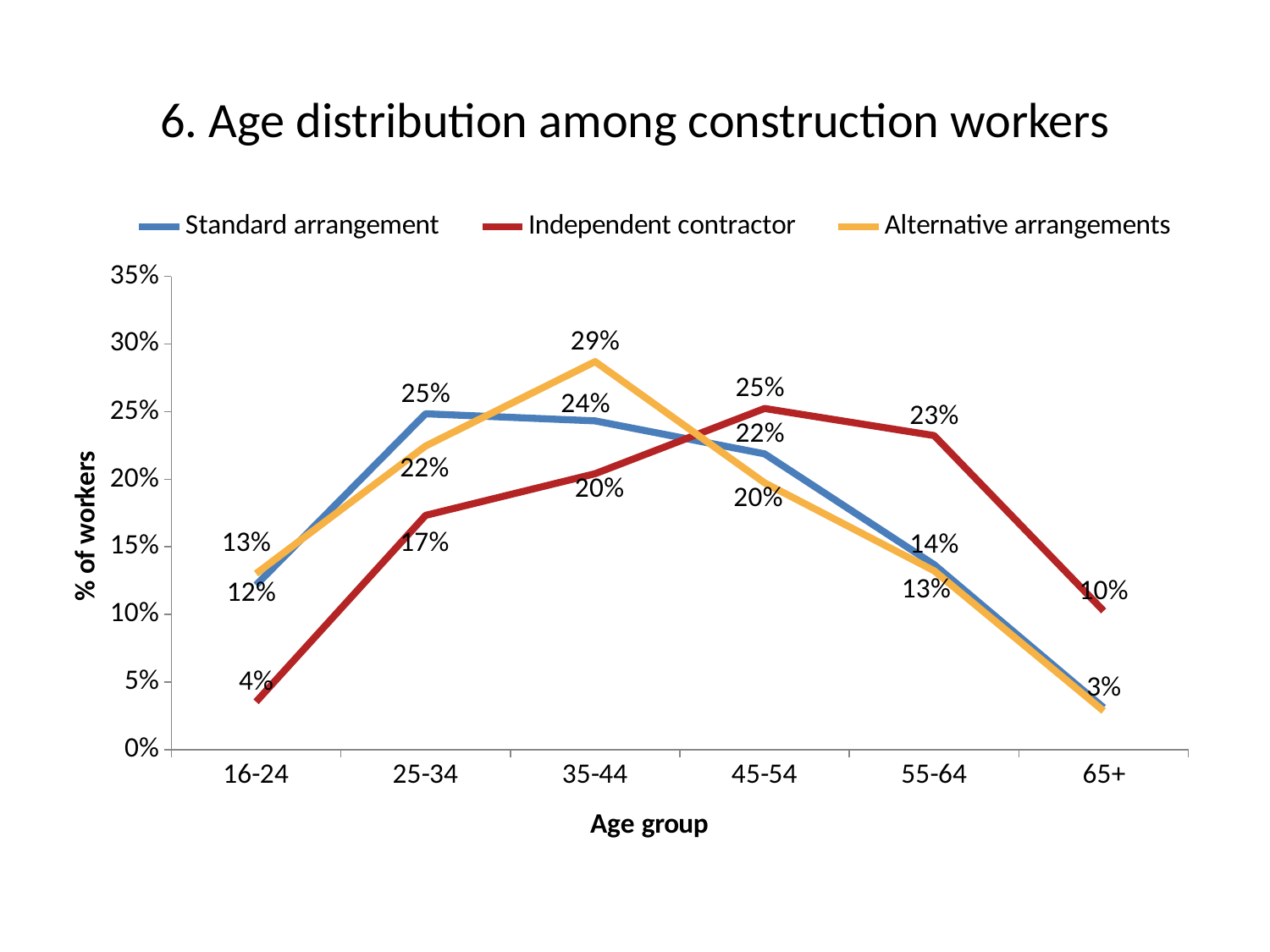
What kind of chart is shown on the slide? Line chart What is the value for Independent contractor in the 16-24 age group? 4% Which age group has the highest value for Alternative arrangements? 35-44 What is the value for Alternative arrangements in the 35-44 age group? 29% In the 35-44 age group, which is larger: Alternative arrangements or Independent contractor? Alternative arrangements Which age group has the highest value for Independent contractor? 45-54 What is the difference between the Independent contractor values for 45-54 and 16-24? 21 percentage points How many series does the legend list? 3 What is the value for Independent contractor in the 65+ age group? 10% What is the value for Standard arrangement in the 25-34 age group? 25% How many age groups are shown on the x axis? 6 Which age group has the lowest value for Independent contractor? 16-24